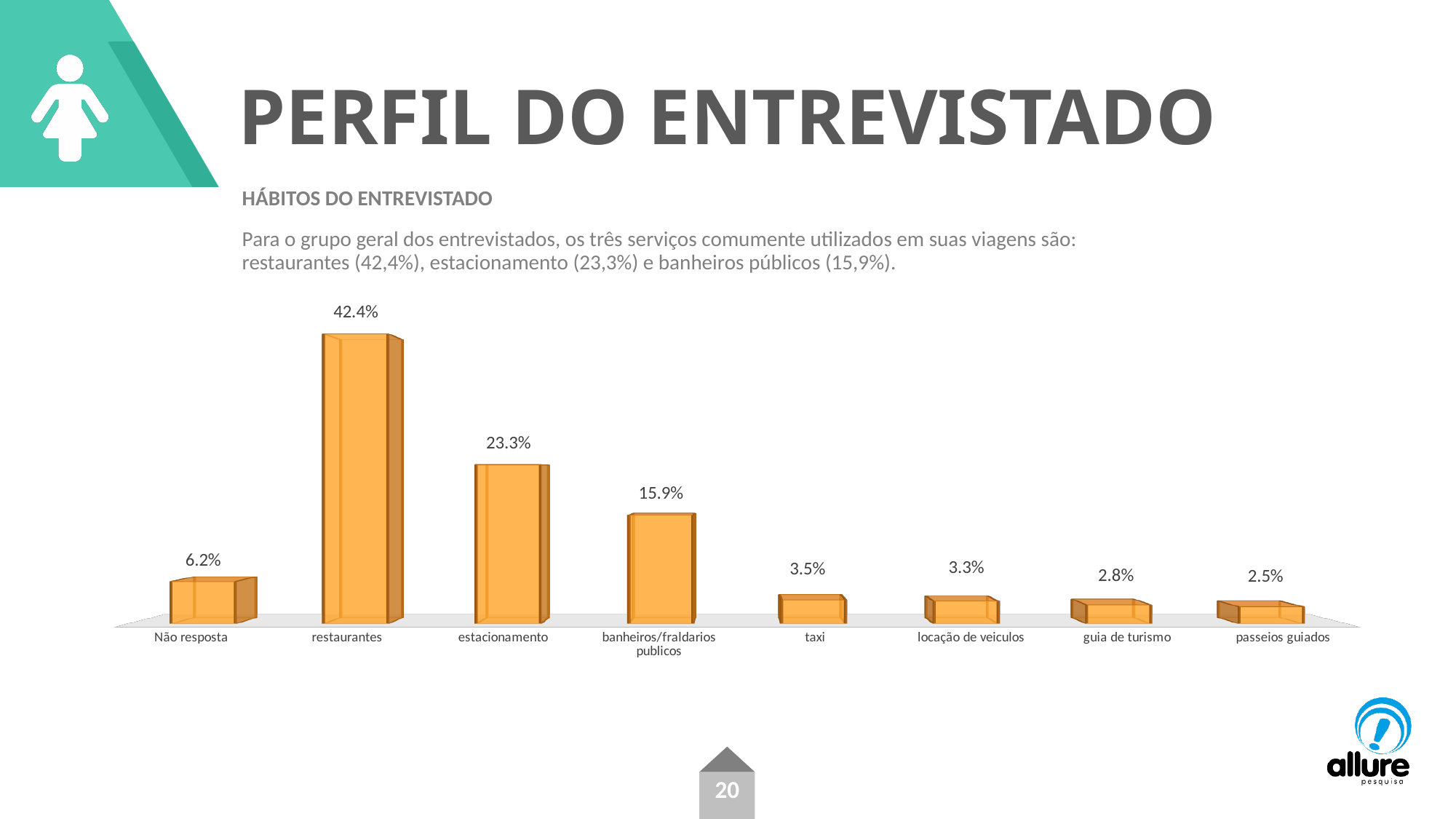
What is the value for restaurantes? 42.4% What kind of chart is shown on the slide? bar chart Which is larger, the value for locação de veiculos or the value for guia de turismo? locação de veiculos What is the difference between the values for restaurantes and estacionamento? 19.1% How many categories are shown in the chart? 8 Which category has the lowest value? passeios guiados Which category has the highest value? restaurantes What is the difference between the values for estacionamento and banheiros/fraldarios publicos? 7.4% What is the value for Não resposta? 6.2% What is the value for banheiros/fraldarios publicos? 15.9% What is the value for taxi? 3.5% What is the value for estacionamento? 23.3%